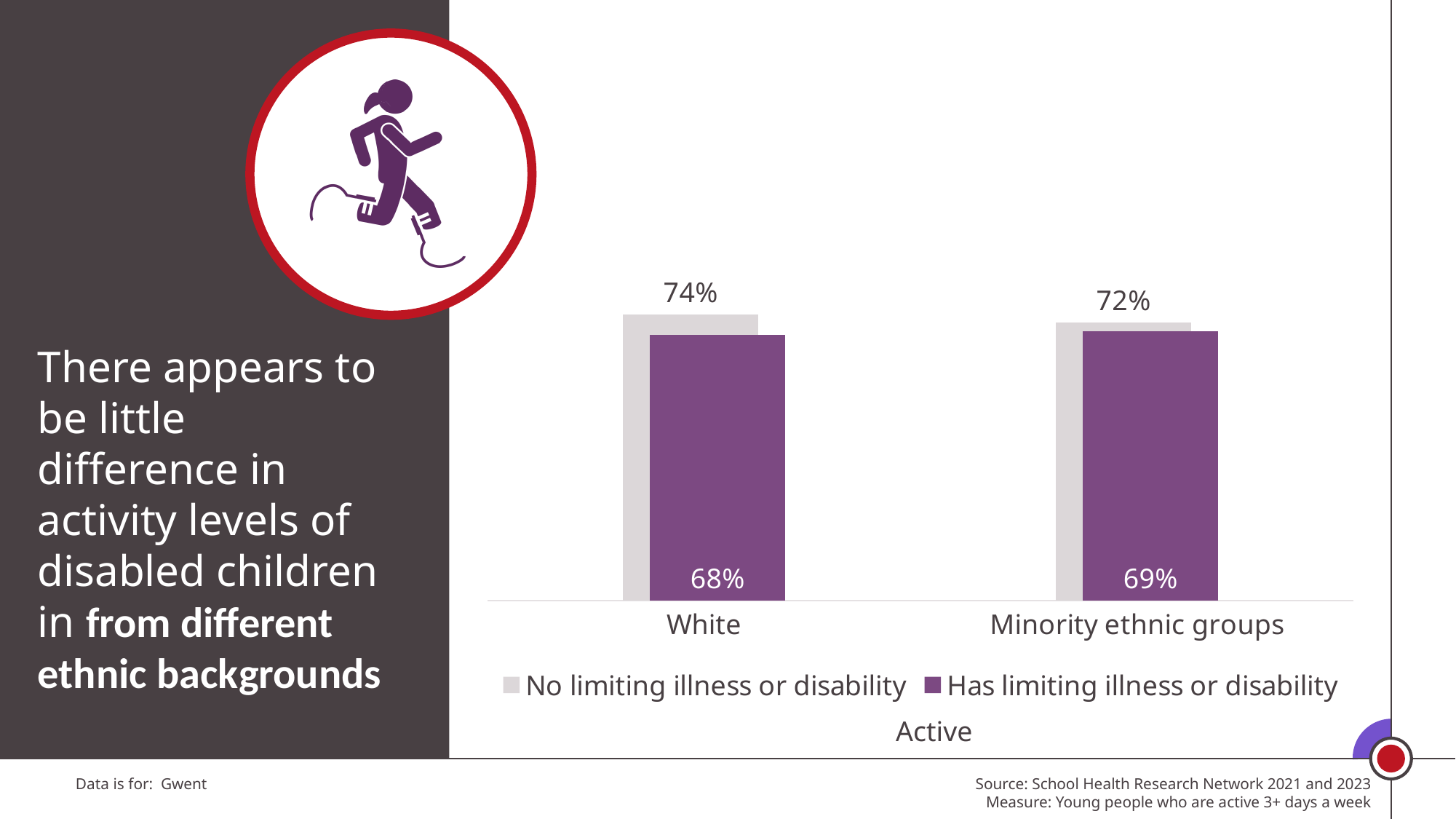
Which category has the highest value in the 'No limiting illness or disability' series? White What is the difference between the 'No limiting illness or disability' and 'Has limiting illness or disability' values for White? 6% What kind of chart is shown on the slide? Bar chart What is the value for Minority ethnic groups in the 'No limiting illness or disability' series? 72% Which category has the lowest value in the 'Has limiting illness or disability' series? White How many categories are shown on the x axis of the chart? 2 Which is larger: the 'No limiting illness or disability' value for White or for Minority ethnic groups? White What is the value for Minority ethnic groups in the 'Has limiting illness or disability' series? 69% What is the value for White in the 'Has limiting illness or disability' series? 68% What is the value for White in the 'No limiting illness or disability' series? 74% How many series does the chart legend list? 2 What is the difference between the 'No limiting illness or disability' and 'Has limiting illness or disability' values for Minority ethnic groups? 3%